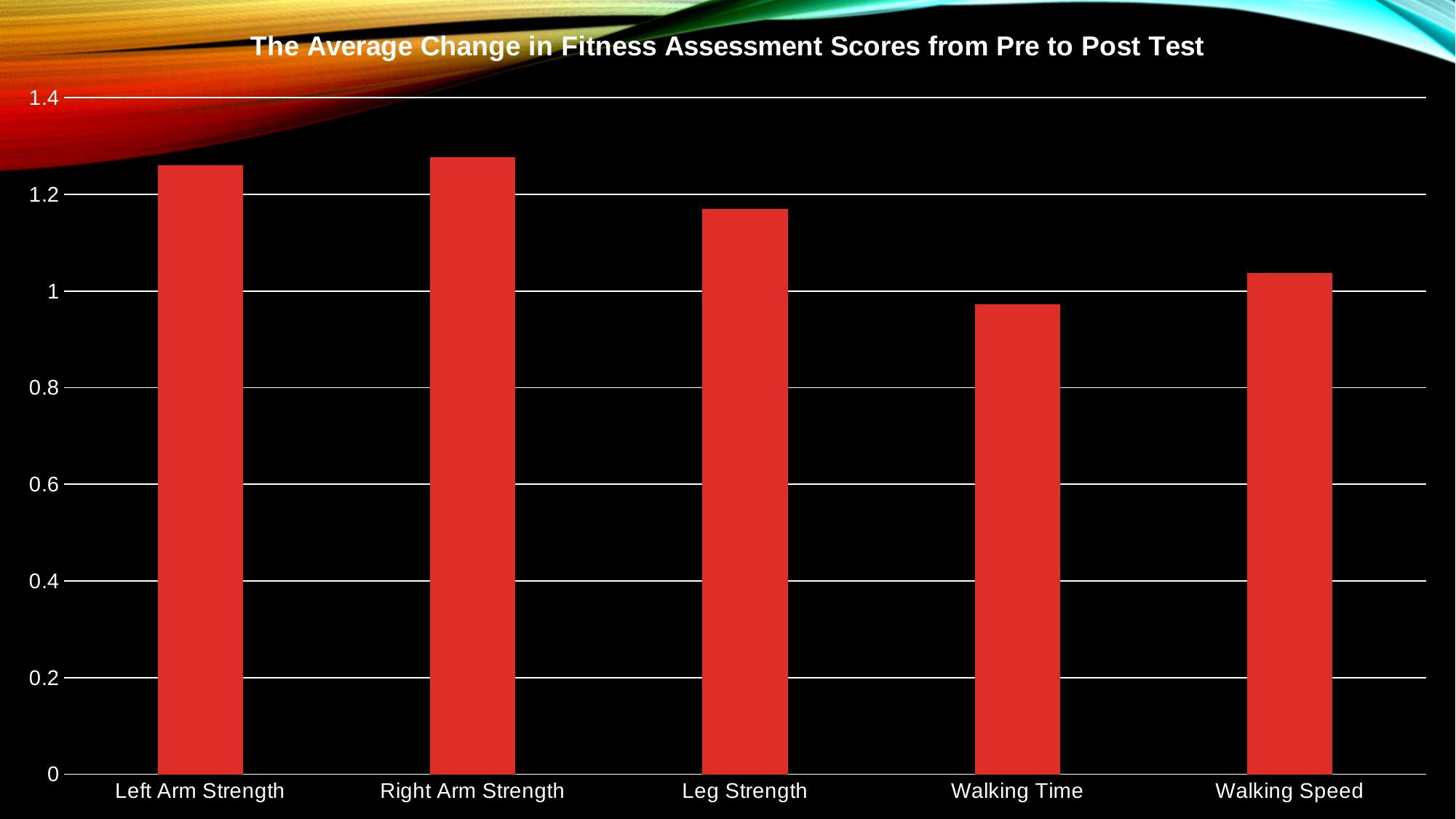
Which is larger, the value for Right Arm Strength or the value for Walking Time? Right Arm Strength Is the value for Right Arm Strength greater or less than 1.2? greater Which is larger, the value for Leg Strength or the value for Walking Speed? Leg Strength What colour are the bars in the chart? red How many categories are shown on the x axis of the chart? 5 What is the title of the chart? The Average Change in Fitness Assessment Scores from Pre to Post Test Is the value for Walking Time greater or less than 1? less Is the value for Left Arm Strength greater or less than 1.2? greater What kind of chart is shown on the slide? bar chart Which category has the lowest average change in fitness assessment score? Walking Time